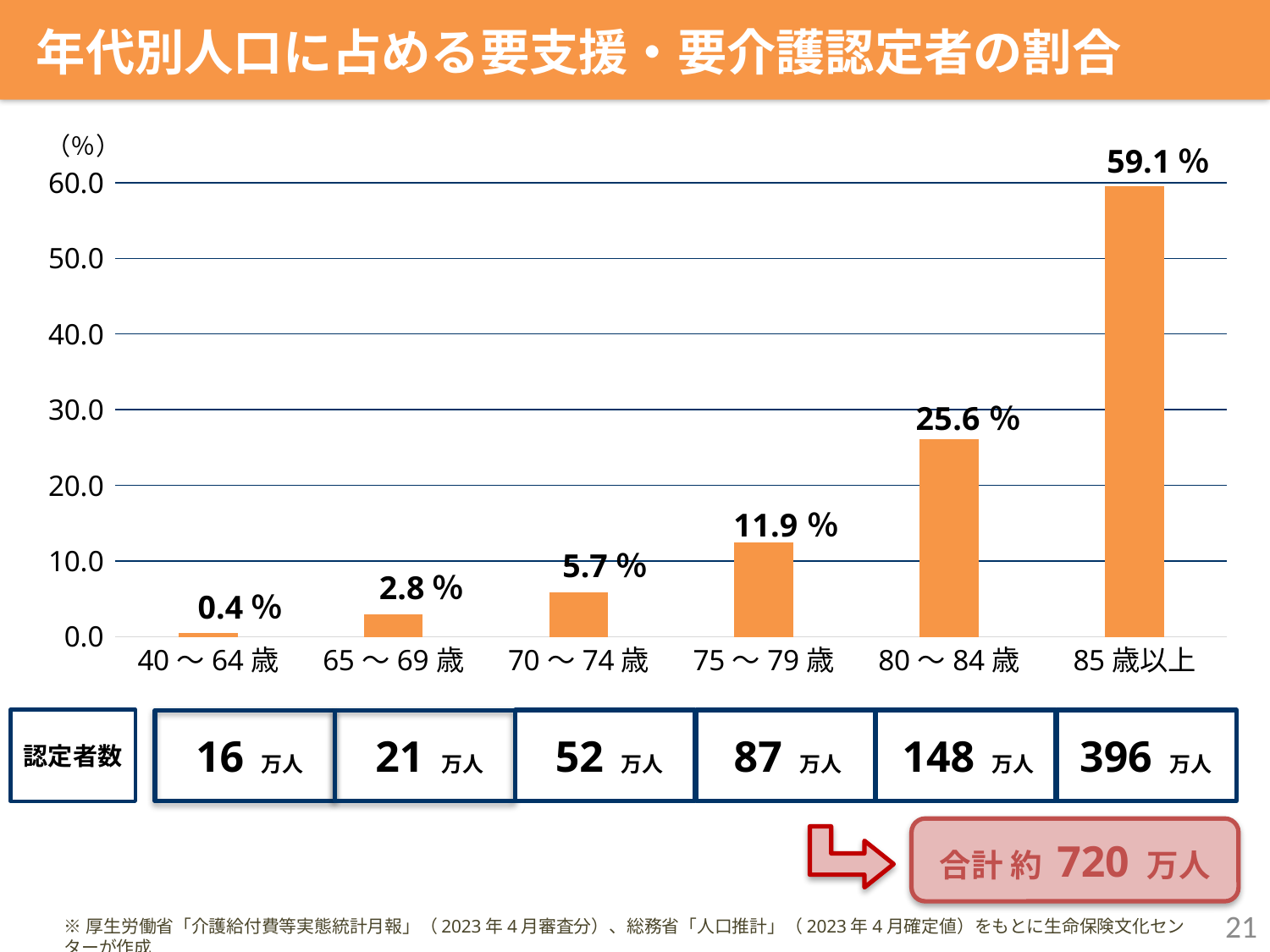
Is the value for 80～84歳 greater or less than 20.0? greater What is the value for 70～74歳? 5.7 % What is the difference between the values for 85歳以上 and 80～84歳? 33.5 % Which age group has the lowest value? 40～64歳 What kind of chart is this? bar chart Which age group has the highest value? 85歳以上 What is the value for 85歳以上? 59.1 % What is the value for 40～64歳? 0.4 % How many age groups are shown on the x axis? 6 What is the difference between the values for 75～79歳 and 70～74歳? 6.2 % Which is larger, the value for 65～69歳 or the value for 75～79歳? 75～79歳 Do the values rise or fall from left to right along the x axis? rise